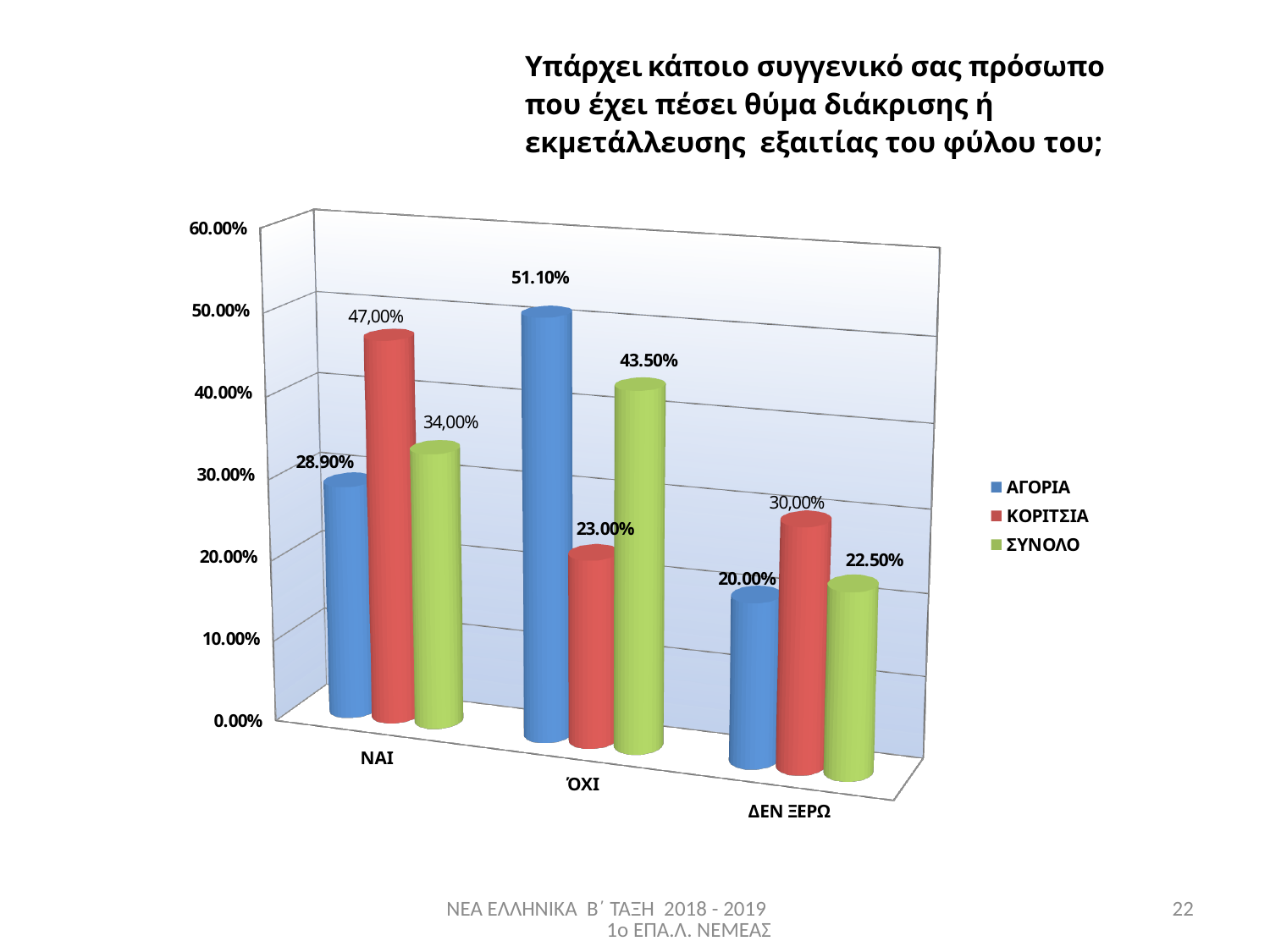
What is the value for ΑΓΟΡΙΑ in the ΝΑΙ category? 28.90% Which is larger in the ΝΑΙ category, the ΑΓΟΡΙΑ value or the ΚΟΡΙΤΣΙΑ value? ΚΟΡΙΤΣΙΑ In which category is the ΚΟΡΙΤΣΙΑ value lowest? ΌΧΙ What is the difference between the ΑΓΟΡΙΑ and ΚΟΡΙΤΣΙΑ values in the ΌΧΙ category? 28.10 percentage points What is the value for ΚΟΡΙΤΣΙΑ in the ΝΑΙ category? 47,00% Is the ΣΥΝΟΛΟ value for ΌΧΙ greater or less than 40.00%? greater What is the value for ΑΓΟΡΙΑ in the ΌΧΙ category? 51.10% How many series does the legend list? 3 How many categories are shown on the x axis? 3 In which category is the ΑΓΟΡΙΑ value highest? ΌΧΙ What kind of chart is shown on the slide? Bar chart What is the value for ΣΥΝΟΛΟ in the ΔΕΝ ΞΕΡΩ category? 22.50%